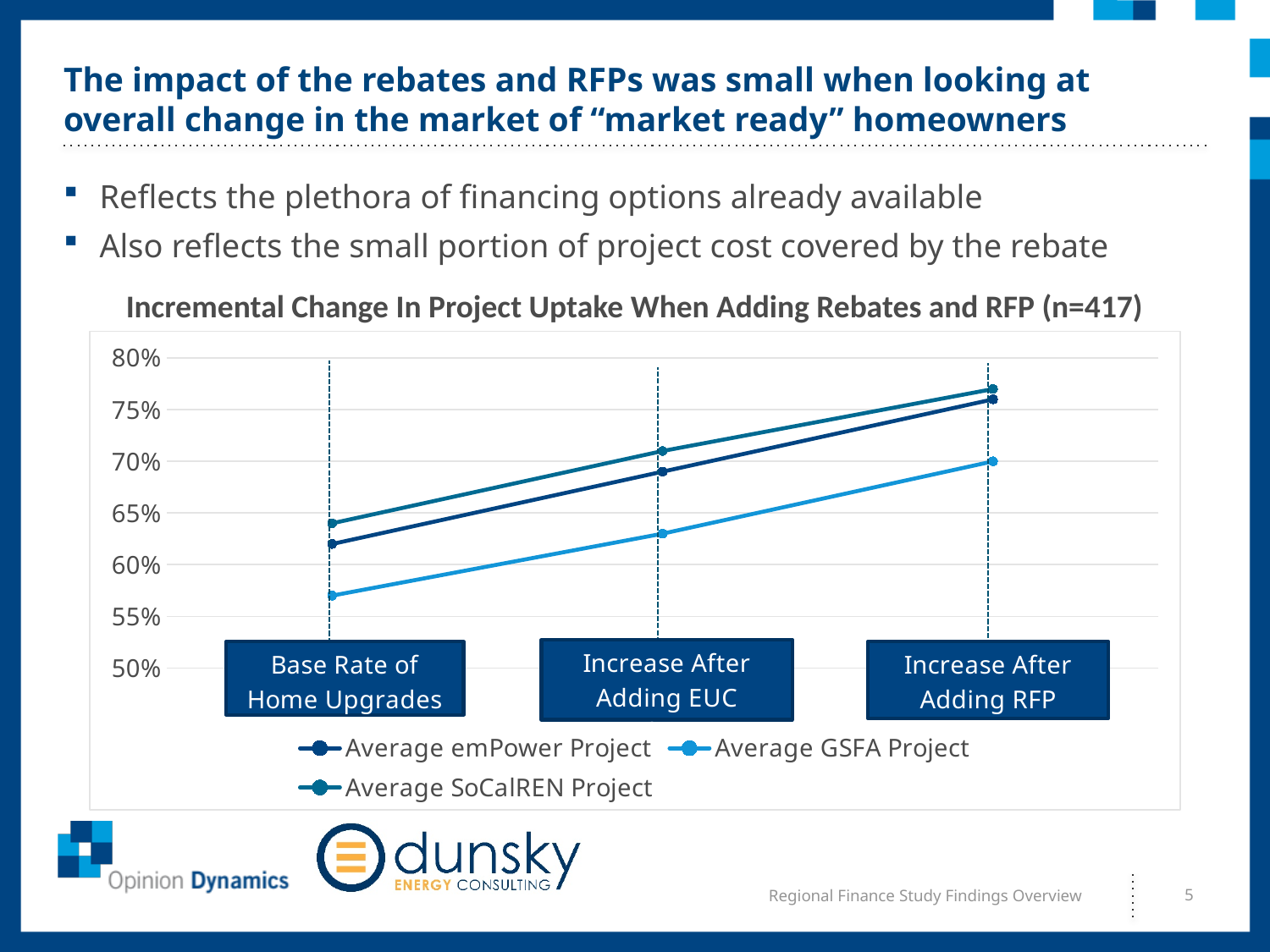
What kind of chart is shown on the slide? line chart How many categories are shown along the x axis? 3 Is the value for Average emPower Project at Base Rate of Home Upgrades greater or less than 60%? greater How many series does the legend list? 3 Is the value for Average emPower Project at Increase After Adding EUC greater or less than 70%? less At Base Rate of Home Upgrades, which is larger: Average SoCalREN Project or Average GSFA Project? Average SoCalREN Project Which series has the lowest value at Base Rate of Home Upgrades? Average GSFA Project Is the value for Average GSFA Project at Increase After Adding EUC greater or less than 60%? greater Do the values for Average GSFA Project rise or fall from Base Rate of Home Upgrades to Increase After Adding RFP? rise Which series has the lowest value at Increase After Adding RFP? Average GSFA Project